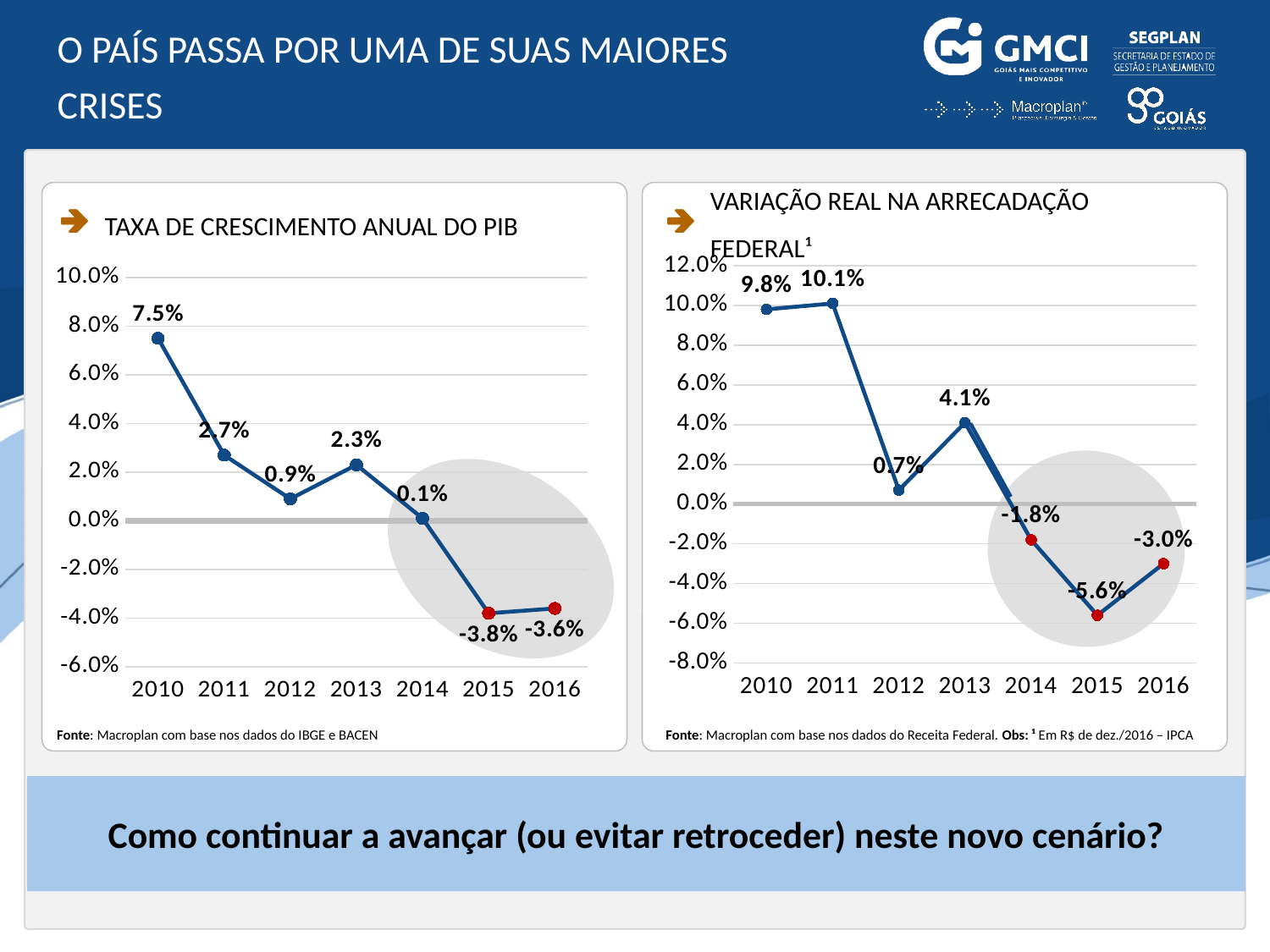
In the chart 'VARIAÇÃO REAL NA ARRECADAÇÃO FEDERAL', what is the difference between the values for 2013 and 2014? 5.9% In the chart 'TAXA DE CRESCIMENTO ANUAL DO PIB', which year has the highest value? 2010 In the chart 'VARIAÇÃO REAL NA ARRECADAÇÃO FEDERAL', what is the value for 2015? -5.6% In the chart 'TAXA DE CRESCIMENTO ANUAL DO PIB', how many years are plotted? 7 What kind of chart is 'VARIAÇÃO REAL NA ARRECADAÇÃO FEDERAL'? Line chart In the chart 'VARIAÇÃO REAL NA ARRECADAÇÃO FEDERAL', which is larger, the value for 2013 or the value for 2012? 2013 In the chart 'TAXA DE CRESCIMENTO ANUAL DO PIB', which year has the lowest value? 2015 In the chart 'VARIAÇÃO REAL NA ARRECADAÇÃO FEDERAL', which year has the lowest value? 2015 In the chart 'TAXA DE CRESCIMENTO ANUAL DO PIB', what is the difference between the values for 2010 and 2011? 4.8% In the chart 'TAXA DE CRESCIMENTO ANUAL DO PIB', what is the value for 2010? 7.5% In the chart 'VARIAÇÃO REAL NA ARRECADAÇÃO FEDERAL', what is the value for 2011? 10.1% In the chart 'TAXA DE CRESCIMENTO ANUAL DO PIB', what is the value for 2015? -3.8%